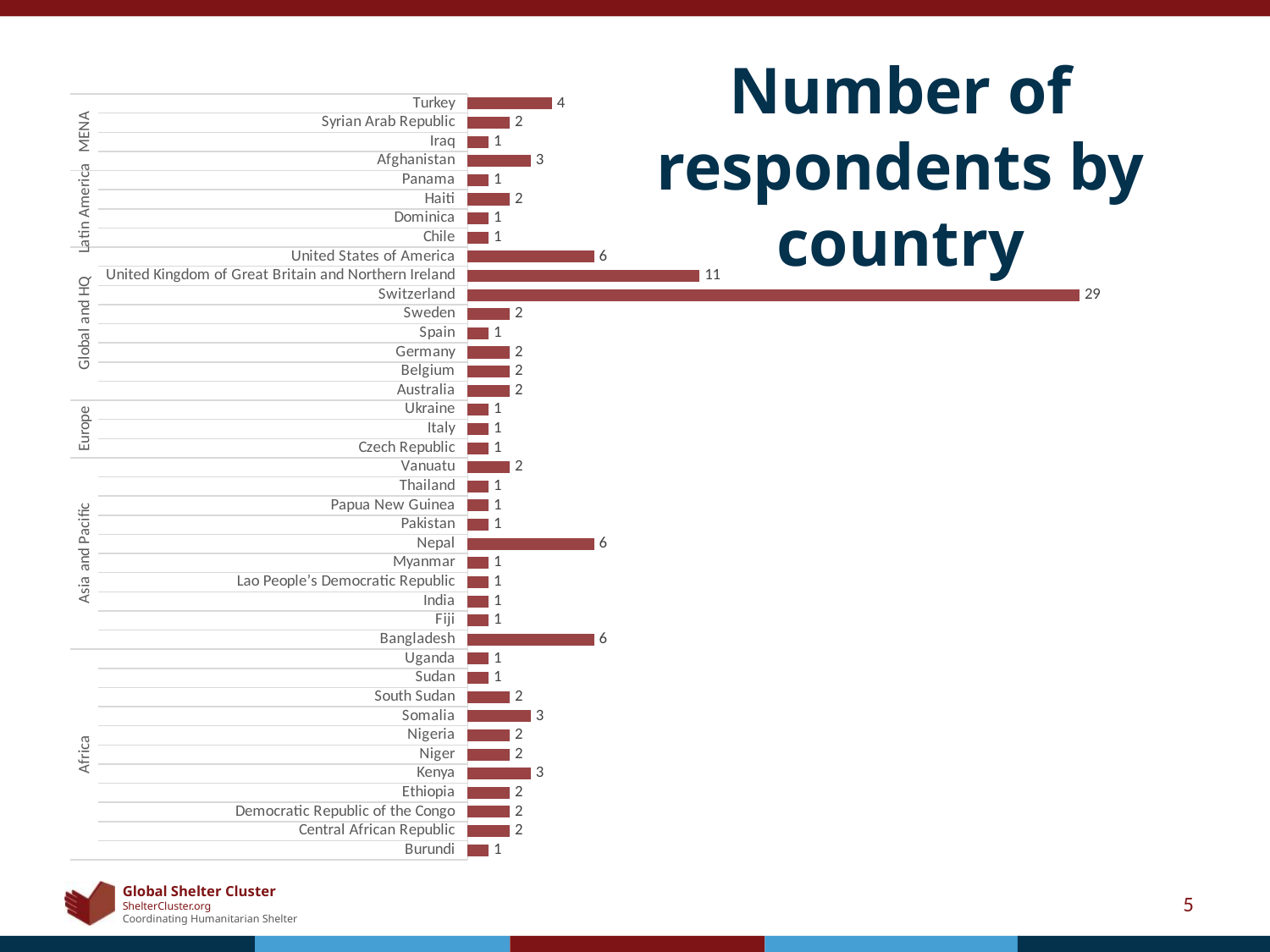
Which has more respondents, Somalia or Nigeria? Somalia Which country has the highest number of respondents? Switzerland What is the number of respondents for the United Kingdom of Great Britain and Northern Ireland? 11 How many countries are listed in the chart? 40 What is the title of the slide? Number of respondents by country What is the number of respondents for Switzerland? 29 What is the difference in respondents between Switzerland and the United Kingdom of Great Britain and Northern Ireland? 18 What is the difference in respondents between the United States of America and Afghanistan? 3 What is the number of respondents for Turkey? 4 What is the number of respondents for Nepal? 6 What type of chart is shown on the slide? Bar chart How many countries are listed under the Africa group? 11